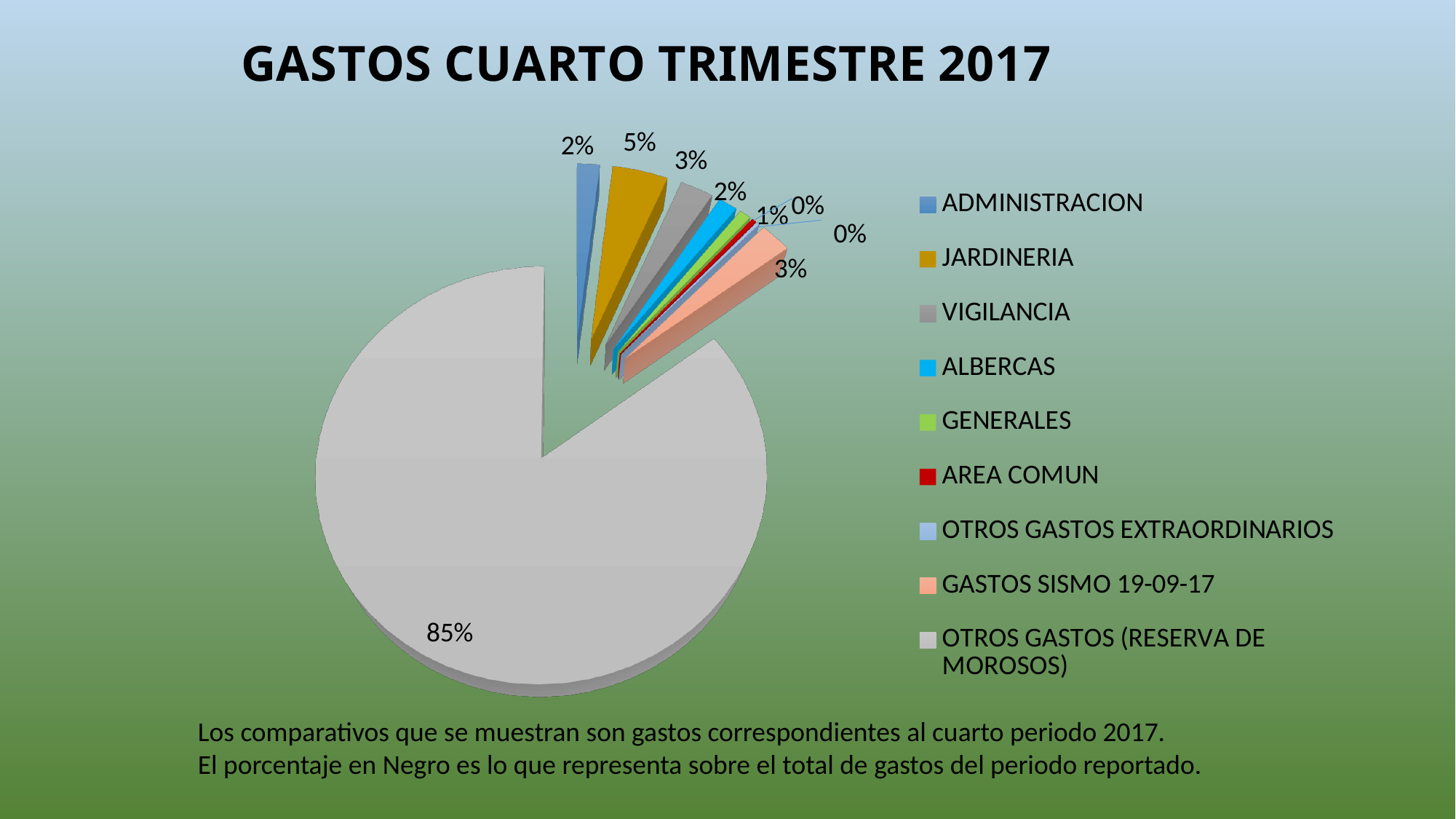
Which category has the largest share of the pie chart? OTROS GASTOS (RESERVA DE MOROSOS) What kind of chart is shown on the slide? Pie chart What percentage does VIGILANCIA represent in the pie chart? 3% How many categories does the legend of the pie chart list? 9 What percentage does JARDINERIA represent in the pie chart? 5% Which has the larger share, JARDINERIA or VIGILANCIA? JARDINERIA What is the title of the chart? GASTOS CUARTO TRIMESTRE 2017 What percentage does OTROS GASTOS (RESERVA DE MOROSOS) represent in the pie chart? 85% What percentage does ADMINISTRACION represent in the pie chart? 2% What percentage does GASTOS SISMO 19-09-17 represent in the pie chart? 3% What percentage does ALBERCAS represent in the pie chart? 2% By how many percentage points does the JARDINERIA share exceed the ADMINISTRACION share? 3 percentage points